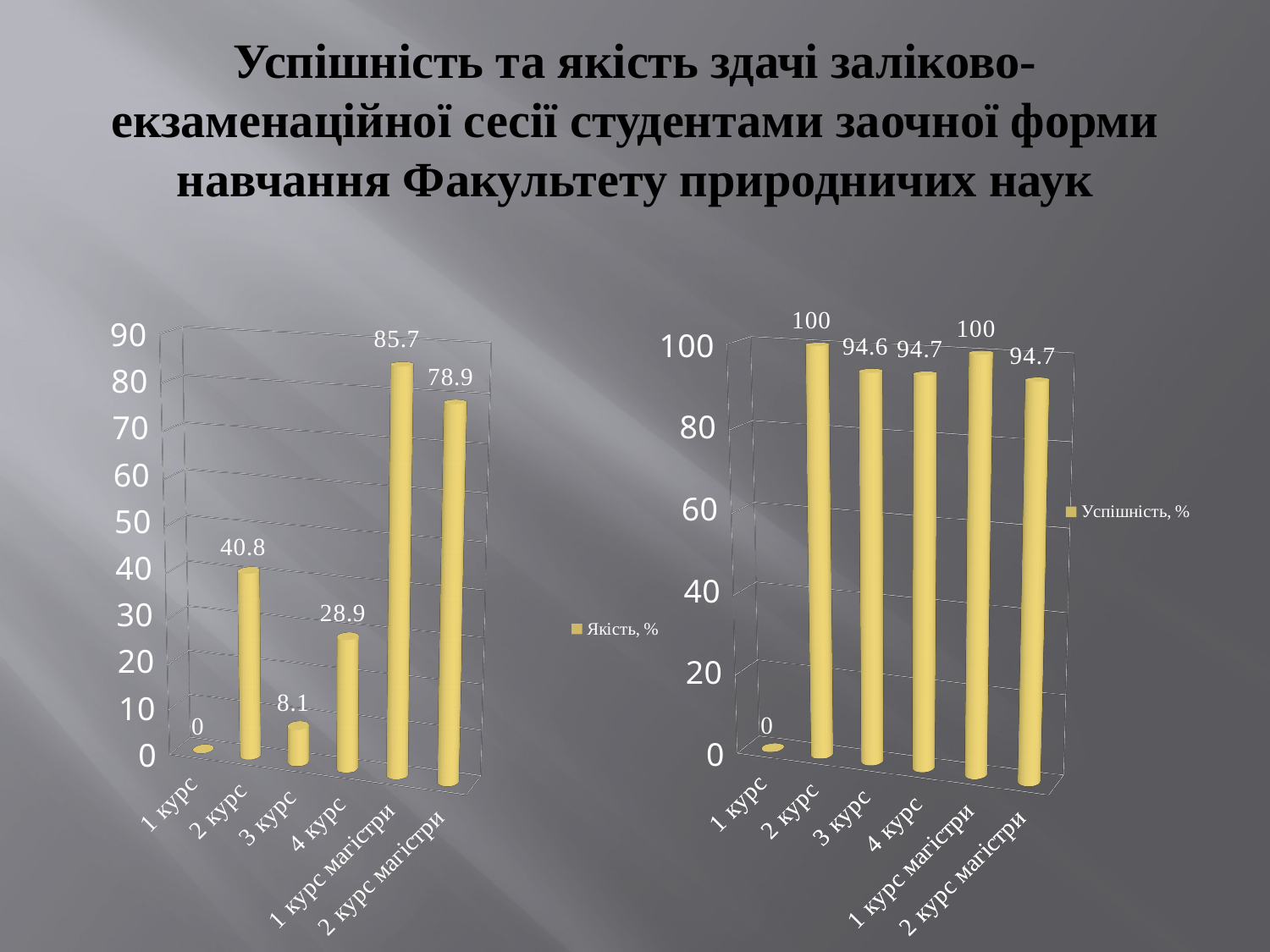
How many categories are shown on the x axis of the right chart (Успішність, %)? 6 In the left chart (Якість, %), which category has the lowest value? 1 курс In the right chart (Успішність, %), what is the value for 3 курс? 94.6 What type of chart is the left chart (Якість, %)? bar chart In the right chart (Успішність, %), is the value for 4 курс greater or less than 80? greater In the left chart (Якість, %), what is the value for 1 курс магістри? 85.7 In the right chart (Успішність, %), what is the difference between the values for 2 курс and 3 курс? 5.4 What series name does the legend of the right chart show? Успішність, % In the left chart (Якість, %), what is the value for 2 курс? 40.8 In the left chart (Якість, %), which category has the highest value? 1 курс магістри In the left chart (Якість, %), what is the difference between the values for 1 курс магістри and 2 курс магістри? 6.8 In the left chart (Якість, %), which is larger: the value for 2 курс or the value for 4 курс? 2 курс